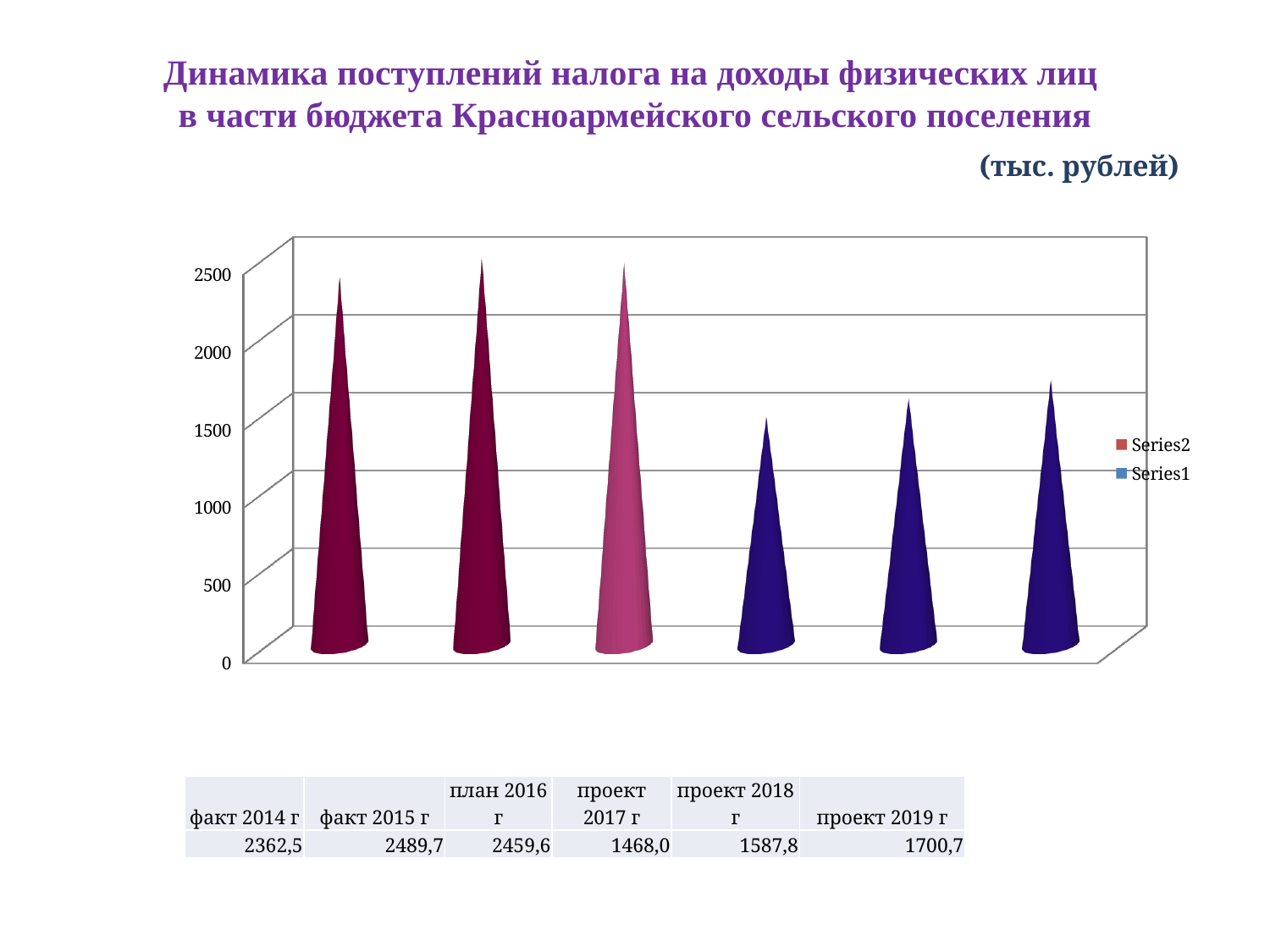
Which category has the highest value? факт 2015 г What is the value for факт 2014 г? 2362,5 Is the value for проект 2017 г greater or less than 1500? less How many categories are shown on the chart? 6 What is the difference between the values for факт 2015 г and факт 2014 г? 127,2 What is the value for проект 2018 г? 1587,8 What is the difference between the values for проект 2019 г and проект 2017 г? 232,7 Which category has the lowest value? проект 2017 г What kind of chart is shown on the slide? bar chart Which is larger, the value for план 2016 г or the value for проект 2019 г? план 2016 г How many series does the legend list? 2 What is the value for план 2016 г? 2459,6